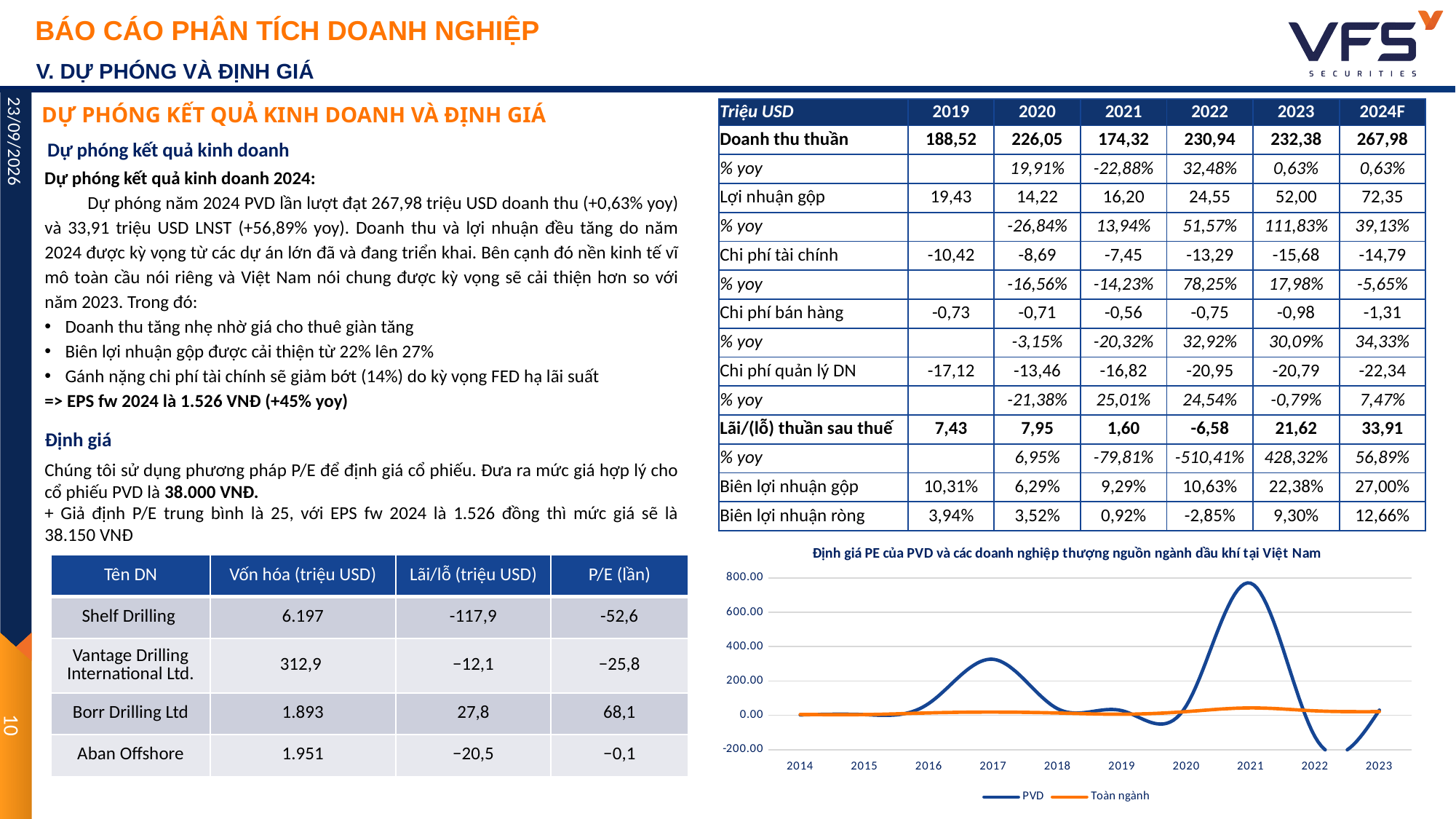
Does the PVD line rise or fall between 2021 and 2022? fall Is the value for PVD in 2021 greater or less than 600.00? greater What is the title of the chart? Định giá PE của PVD và các doanh nghiệp thượng nguồn ngành dầu khí tại Việt Nam What are the two series named in the chart legend? PVD and Toàn ngành In which year does the PVD line reach its lowest value? 2022 In which year does the PVD line reach its highest value? 2021 How many series does the legend of the chart list? 2 Is the value for PVD in 2017 greater or less than 200.00? greater What kind of chart is shown on the slide? line chart Which series has the larger value in 2021, PVD or Toàn ngành? PVD How many years are shown along the x axis of the chart? 10 Is the value for PVD in 2022 greater or less than 0.00? less